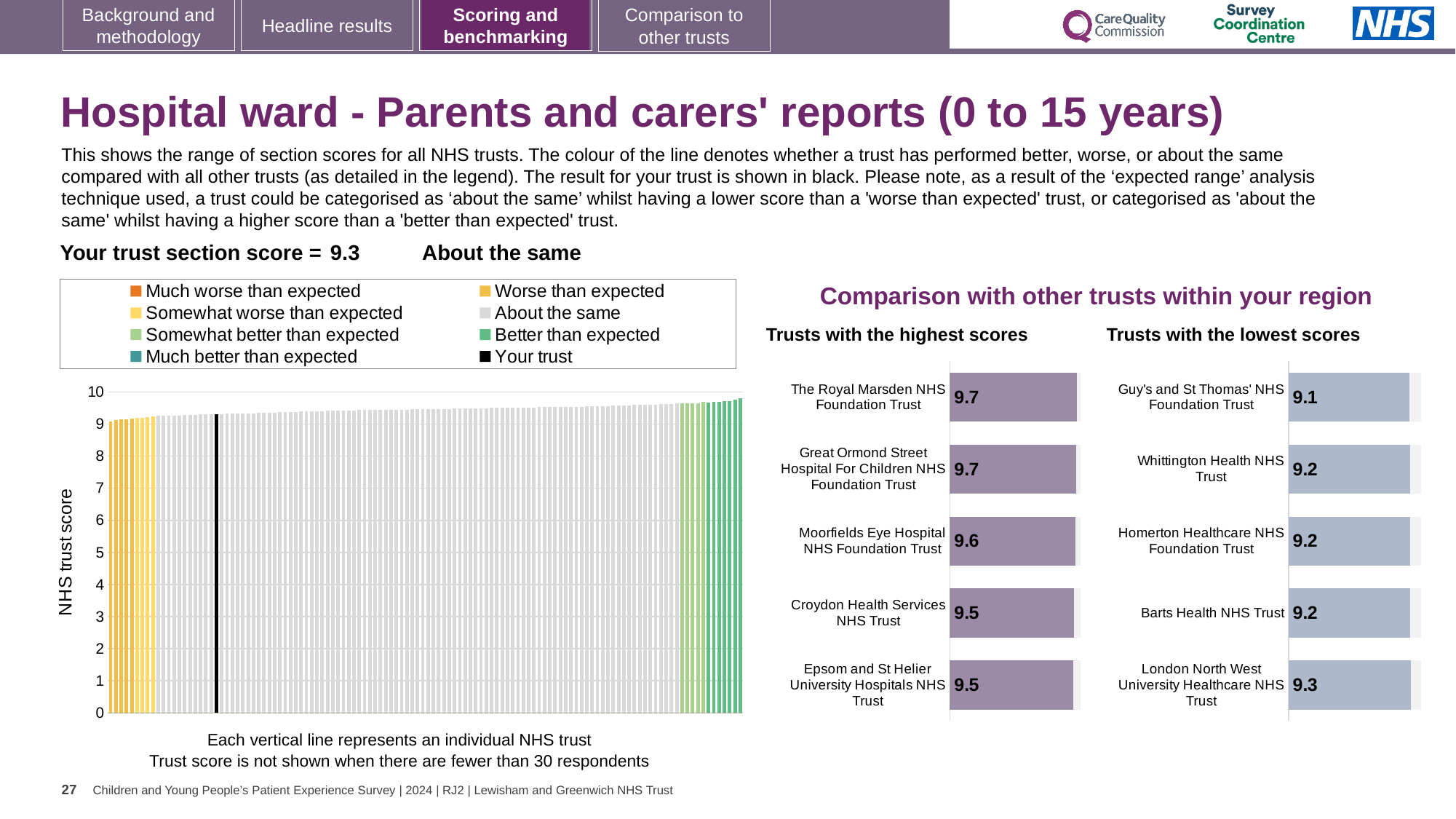
What is the y-axis label of the large chart on the left? NHS trust score In the 'Trusts with the highest scores' chart, which has the larger score: The Royal Marsden NHS Foundation Trust or Moorfields Eye Hospital NHS Foundation Trust? The Royal Marsden NHS Foundation Trust What kind of chart is the large chart on the left showing NHS trust scores? Bar chart In the 'Trusts with the lowest scores' chart, what is the score for Guy's and St Thomas' NHS Foundation Trust? 9.1 In the 'Trusts with the highest scores' chart, what is the score for Moorfields Eye Hospital NHS Foundation Trust? 9.6 How many trusts are shown in the 'Trusts with the lowest scores' chart? 5 In the large chart on the left, do the trust scores rise or fall from left to right along the x axis? Rise In the 'Trusts with the lowest scores' chart, which trust has the lowest score? Guy's and St Thomas' NHS Foundation Trust In the 'Trusts with the lowest scores' chart, what is the difference between the score for London North West University Healthcare NHS Trust and the score for Guy's and St Thomas' NHS Foundation Trust? 0.2 In the 'Trusts with the lowest scores' chart, which trust has the highest score? London North West University Healthcare NHS Trust In the 'Trusts with the highest scores' chart, what is the difference between the score for The Royal Marsden NHS Foundation Trust and the score for Croydon Health Services NHS Trust? 0.2 How many entries does the legend above the large chart on the left list? 8